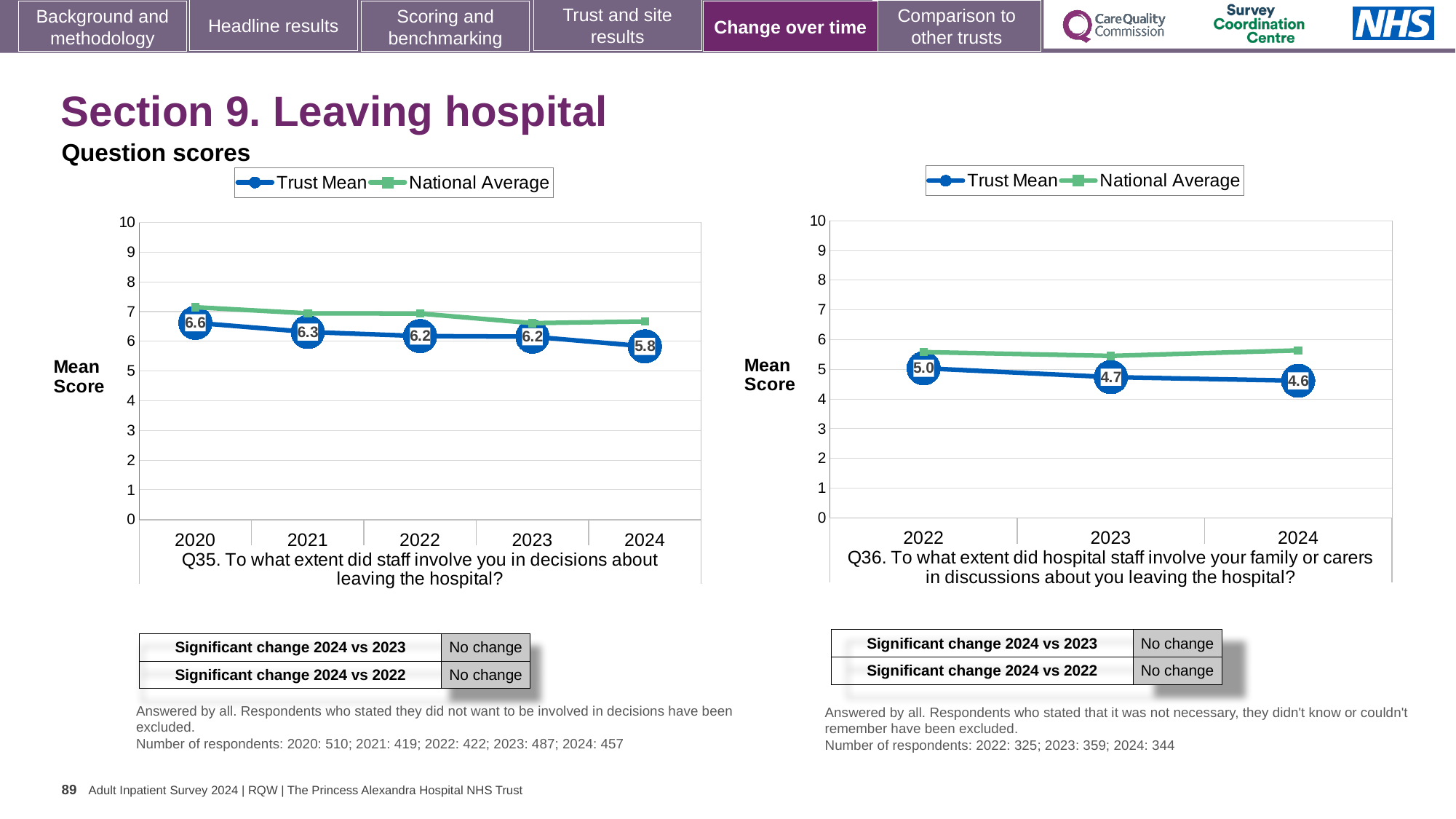
In the Q36 chart (right), what is the Trust Mean for 2023? 4.7 What kind of chart is the Q35 chart (left)? Line chart In the Q36 chart (right), is the National Average for 2022 greater or less than 5? greater In the Q35 chart (left), what is the Trust Mean for 2020? 6.6 In the Q35 chart (left), what is the difference between the Trust Mean in 2020 and in 2024? 0.8 How many series does the legend of the Q35 chart (left) list? 2 In the Q35 chart (left), what is the Trust Mean for 2024? 5.8 In the Q36 chart (right), which year has the lowest Trust Mean? 2024 In the Q35 chart (left), which year has the highest Trust Mean? 2020 In the Q36 chart (right), what is the difference between the Trust Mean in 2022 and in 2024? 0.4 In the Q35 chart (left), is the Trust Mean higher in 2021 or in 2024? 2021 How many years are plotted on the x axis of the Q36 chart (right)? 3